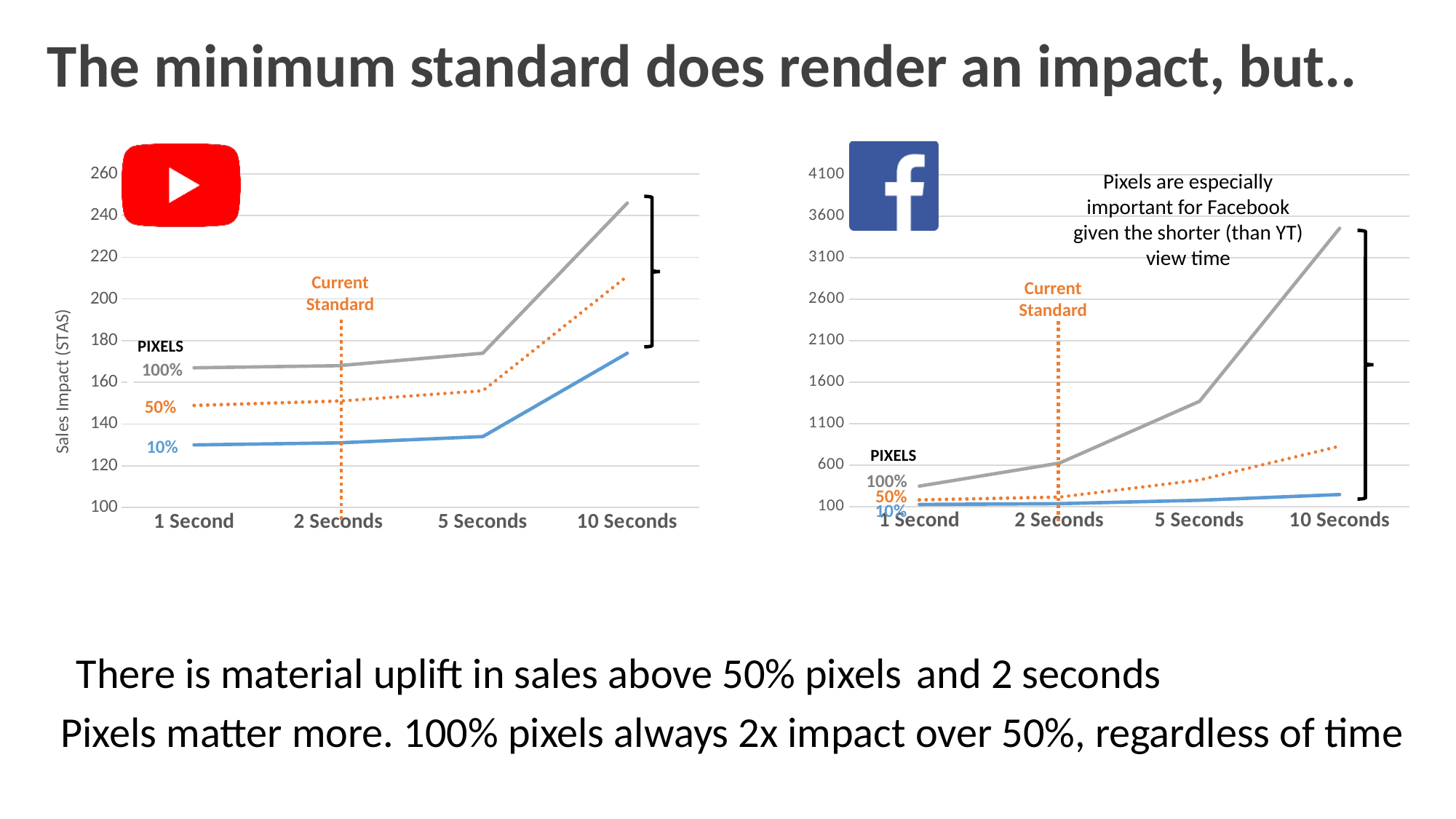
On the left (YouTube) chart, is the value for 10% pixels at 1 Second greater or less than 140? less What is the y-axis label on the left (YouTube) chart? Sales Impact (STAS) On the right (Facebook) chart, is the value for 100% pixels at 10 Seconds greater or less than 3100? greater How many x-axis categories does the right (Facebook) chart have? 4 On the right (Facebook) chart, which is larger at 5 Seconds: the 100% pixels value or the 50% pixels value? 100% pixels How many pixel series are plotted on the left (YouTube) chart? 3 On the right (Facebook) chart, which pixel series is highest at 10 Seconds? 100% On the left (YouTube) chart, is the value for 50% pixels at 10 Seconds greater or less than 200? greater On the left (YouTube) chart, which pixel series is lowest at 1 Second? 10% What type of chart is the left (YouTube) chart? line chart On the left (YouTube) chart, does the 100% pixels line rise or fall from 1 Second to 10 Seconds? rise